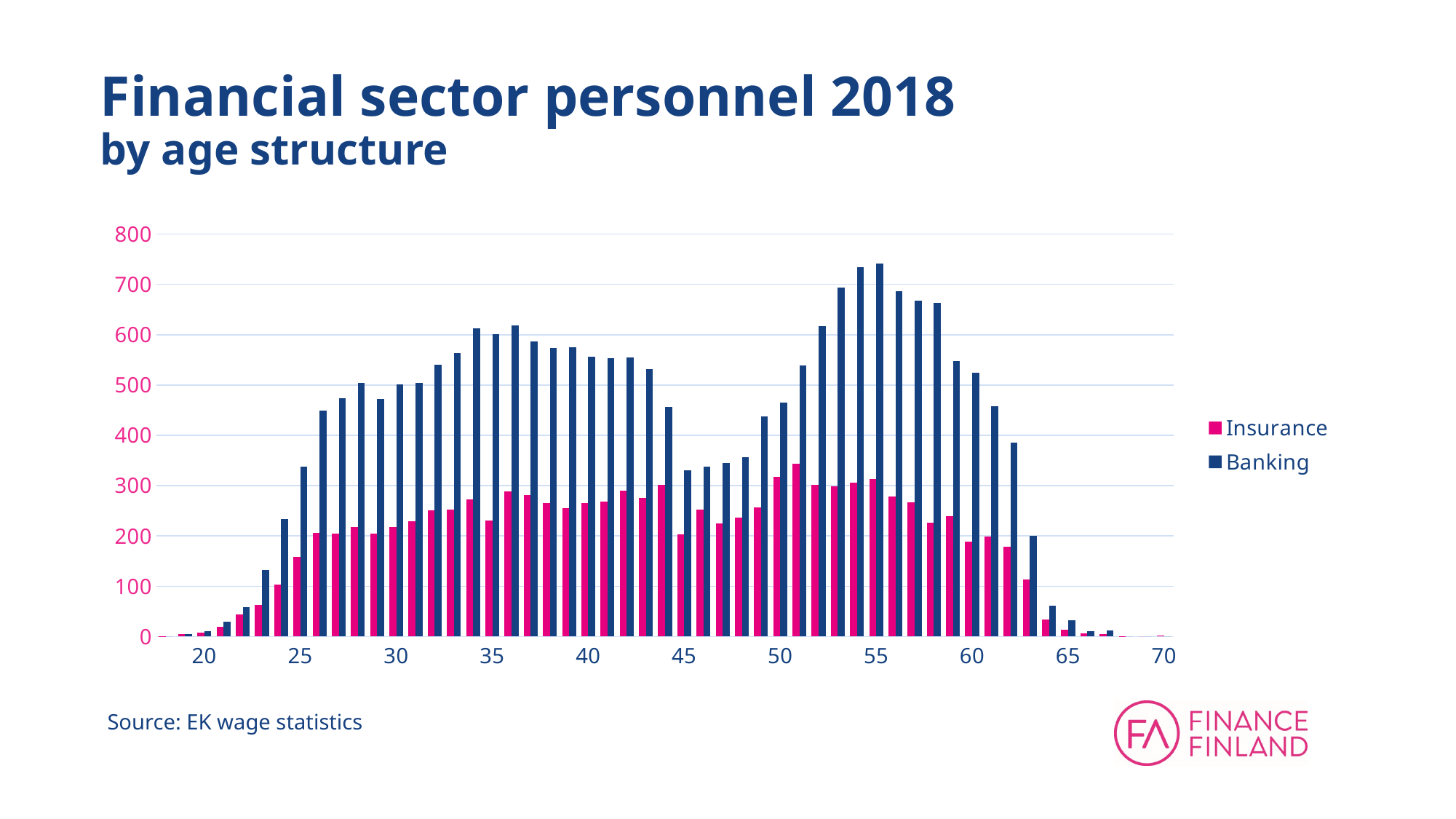
At age 45, which series has the larger value, Insurance or Banking? Banking Is the Banking value at age 55 greater or less than 700? greater How many series does the legend list? 2 Is the Insurance value at age 51 greater or less than 300? greater Which colour represents the Banking series? Dark blue Is the Insurance value at age 40 greater or less than 200? greater Which two series are listed in the legend? Insurance and Banking What kind of chart is shown on the slide? Bar chart Do the Banking values rise or fall from age 45 to age 55? Rise Which is larger, the Banking value at age 40 or the Banking value at age 45? Age 40